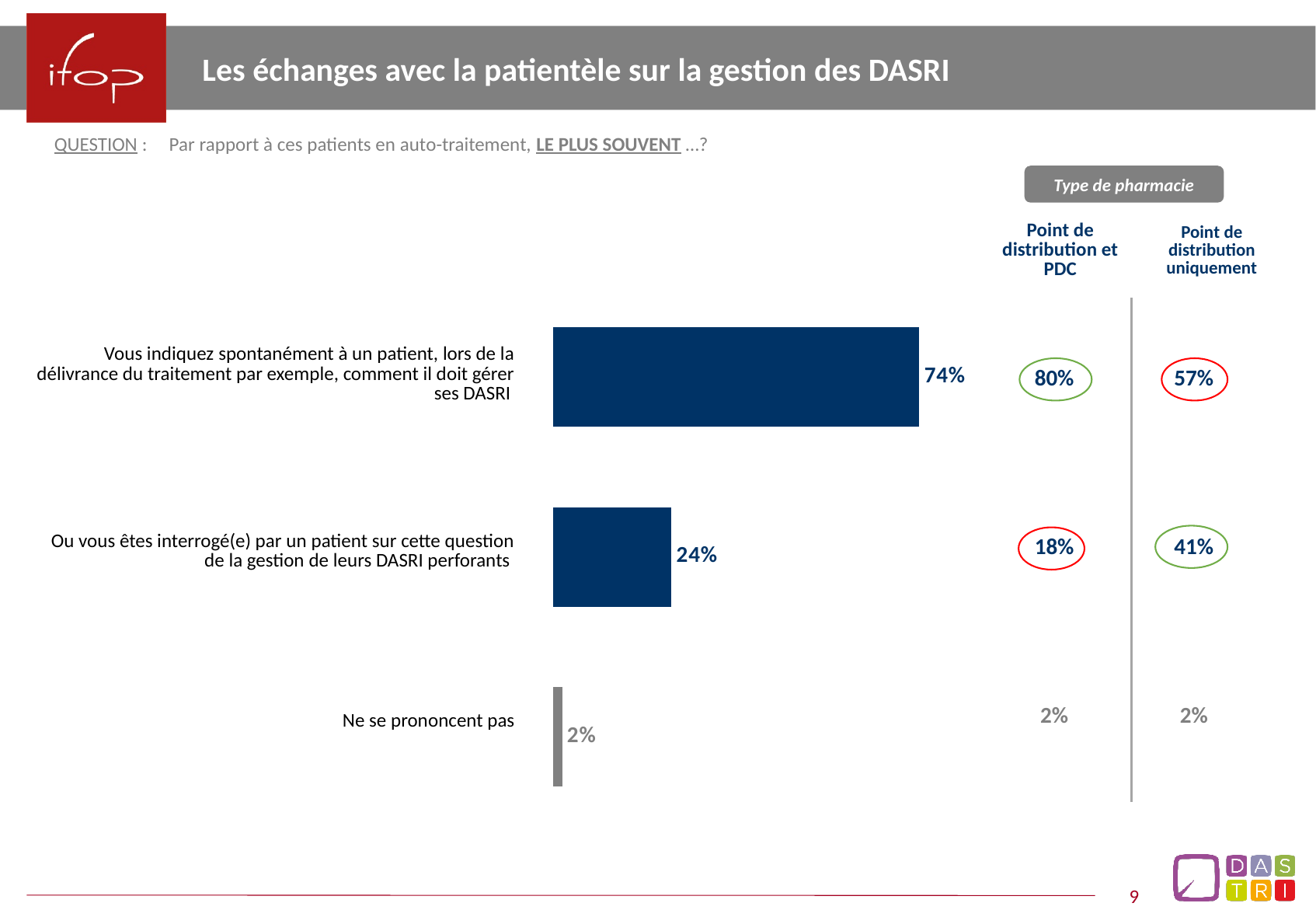
Which response has the highest percentage in the bar chart? Vous indiquez spontanément à un patient, lors de la délivrance du traitement par exemple, comment il doit gérer ses DASRI What percentage of respondents say they are asked by a patient about managing their sharps DASRI? 24% In the 'Point de distribution uniquement' column, what percentage are asked by a patient about managing their DASRI? 41% How many response categories are shown in the bar chart? 3 Which response has the lowest percentage in the bar chart? Ne se prononcent pas Which is larger: the share who spontaneously inform patients or the share who are asked by patients? The share who spontaneously inform patients (74%) What percentage of respondents say they spontaneously tell a patient how to manage their DASRI? 74% In the 'Point de distribution et PDC' column, what percentage spontaneously tell patients how to manage their DASRI? 80% What is the difference in percentage points between the 'Vous indiquez spontanément' response and the 'Ou vous êtes interrogé(e) par un patient' response? 50 percentage points What type of chart is used on this slide? Horizontal bar chart What is the value for 'Ne se prononcent pas'? 2% What is the title of the slide? Les échanges avec la patientèle sur la gestion des DASRI